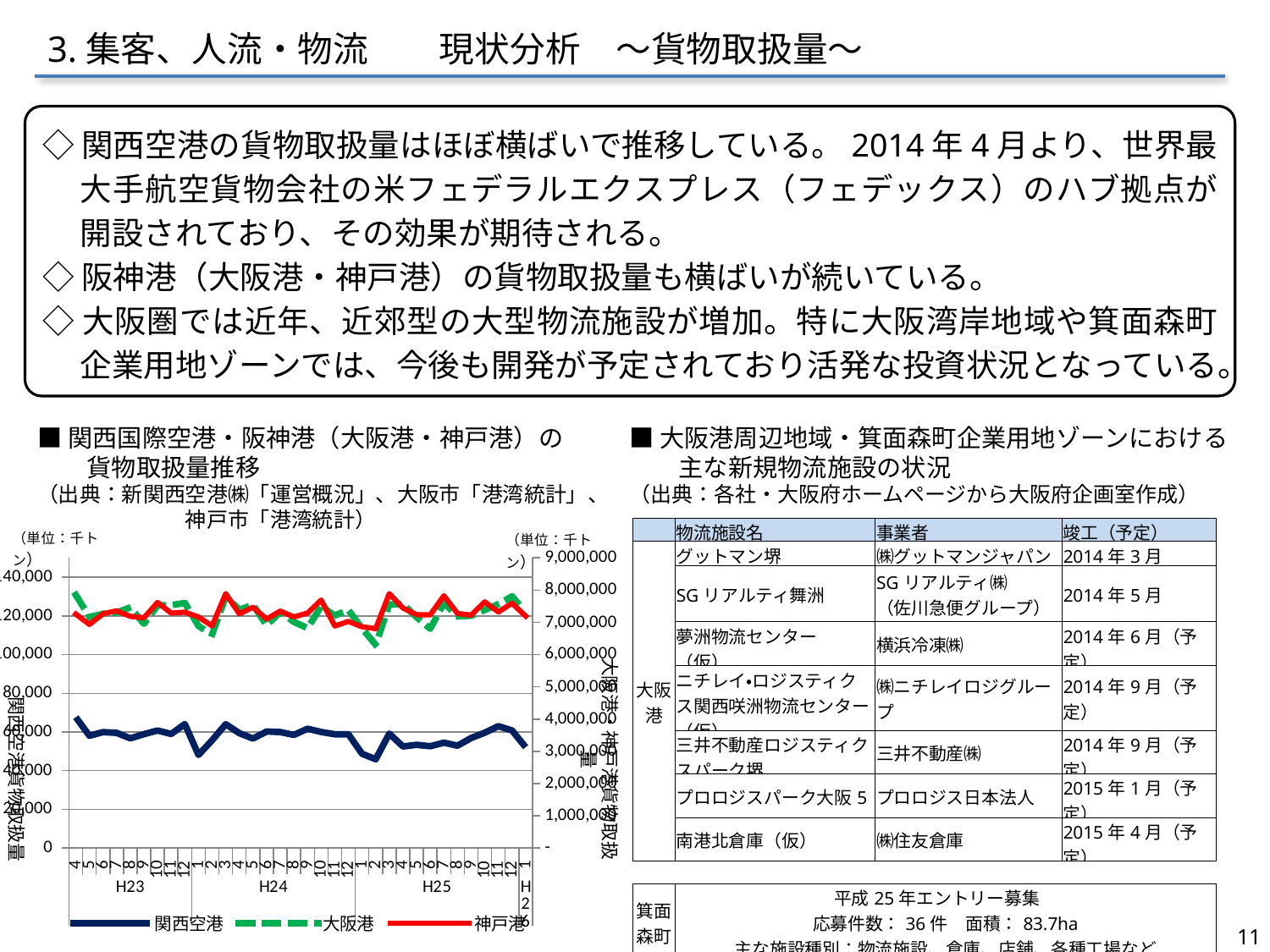
Is the value for 神戸港 in month 4 of H23 greater or less than 6,000,000? greater What is the highest tick value on the right-hand axis of the chart? 9,000,000 Is the value for 大阪港 in month 12 of H25 greater or less than 8,000,000? less How many series does the chart legend list? 3 What kind of chart is shown on the slide? line chart What unit is shown for the chart's axes? 千トン What is the highest tick value on the left-hand axis of the chart? 140,000 How many fiscal-year groups (H23, H24, ...) are labelled on the x axis of the chart? 4 Is the value for 関西空港 in month 4 of H23 greater or less than 80,000? less Does the 関西空港 series show a strong rising trend, a strong falling trend, or stay roughly flat across the x axis? roughly flat Which series are listed in the chart legend? 関西空港, 大阪港, 神戸港